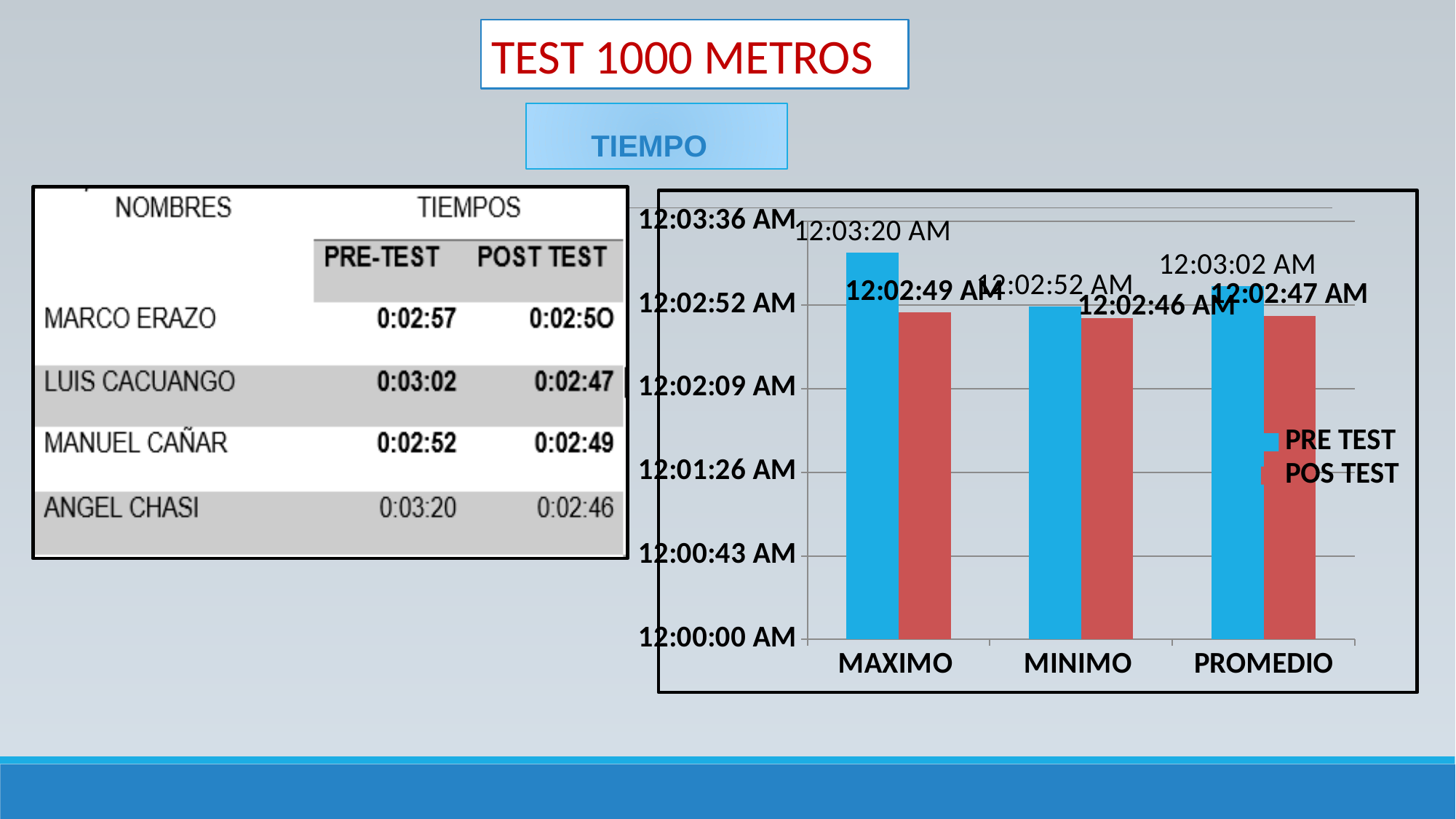
What is the PRE TEST value for PROMEDIO in the chart? 12:03:02 AM What kind of chart is shown on the slide? bar chart What is the POS TEST value for PROMEDIO in the chart? 12:02:47 AM What is the POS TEST value for MAXIMO in the chart? 12:02:49 AM Which category has the highest PRE TEST value in the chart? MAXIMO What is the PRE TEST value for MAXIMO in the chart? 12:03:20 AM What is the PRE TEST value for MINIMO in the chart? 12:02:52 AM What are the two series named in the chart legend? PRE TEST and POS TEST What is the POS TEST value for MINIMO in the chart? 12:02:46 AM How many categories are shown on the x axis of the chart? 3 How many series does the chart legend list? 2 For MAXIMO, which is larger in the chart: the PRE TEST value or the POS TEST value? PRE TEST